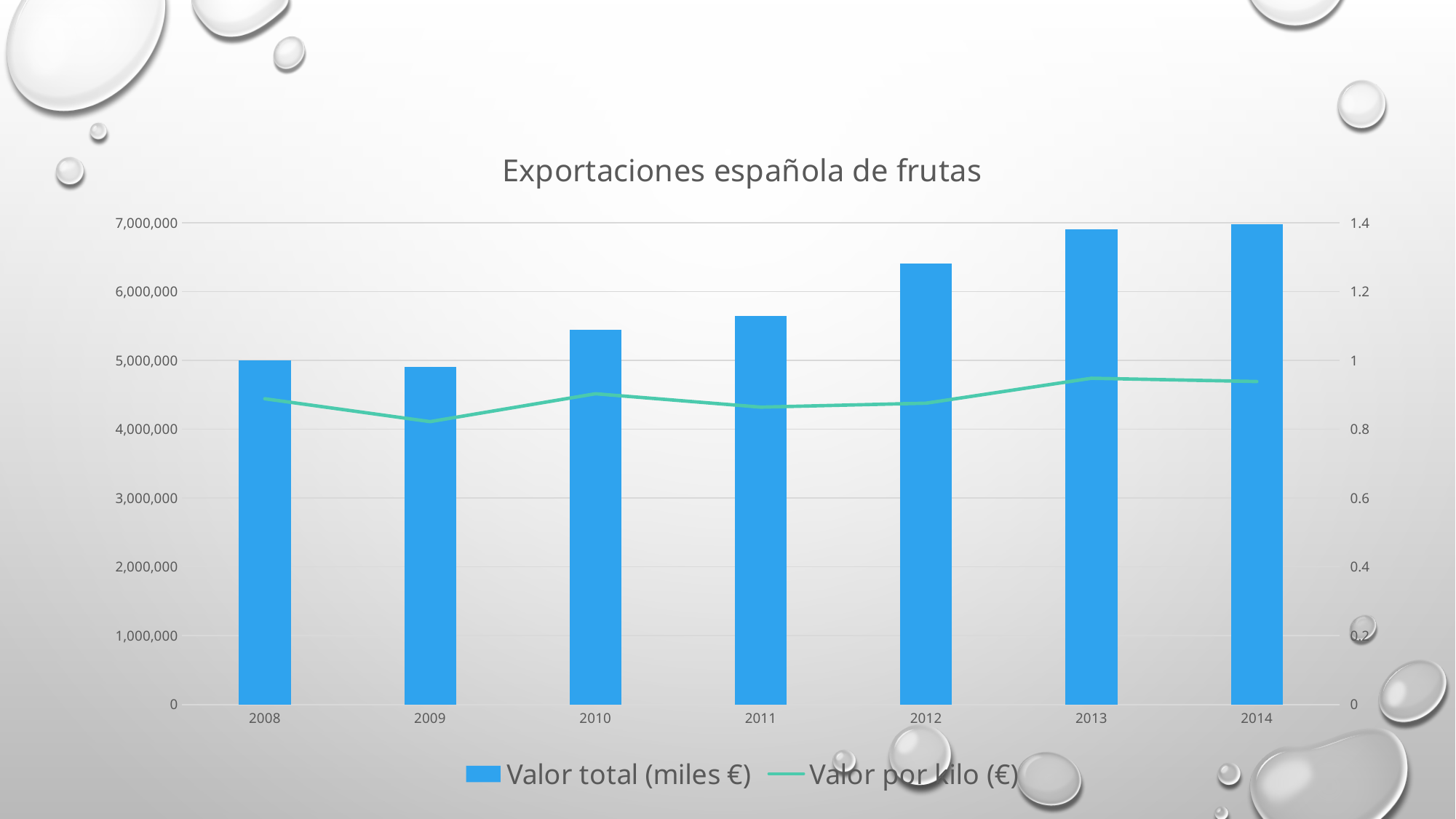
Do the Valor total (miles €) bars generally rise or fall from 2008 to 2014? rise What is the title of the chart? Exportaciones española de frutas Is the Valor total (miles €) bar for 2011 greater or less than 6,000,000? less How many years are shown on the x axis? 7 What kind of chart is this? Combined bar and line chart Which year has the lowest Valor por kilo (€) value? 2009 Is the Valor total (miles €) bar for 2012 greater or less than 6,000,000? greater Is the Valor total (miles €) bar for 2009 greater or less than 5,000,000? less How many series does the legend list? 2 What are the two series named in the legend? Valor total (miles €) and Valor por kilo (€) Which is larger, the Valor total (miles €) bar for 2010 or for 2009? 2010